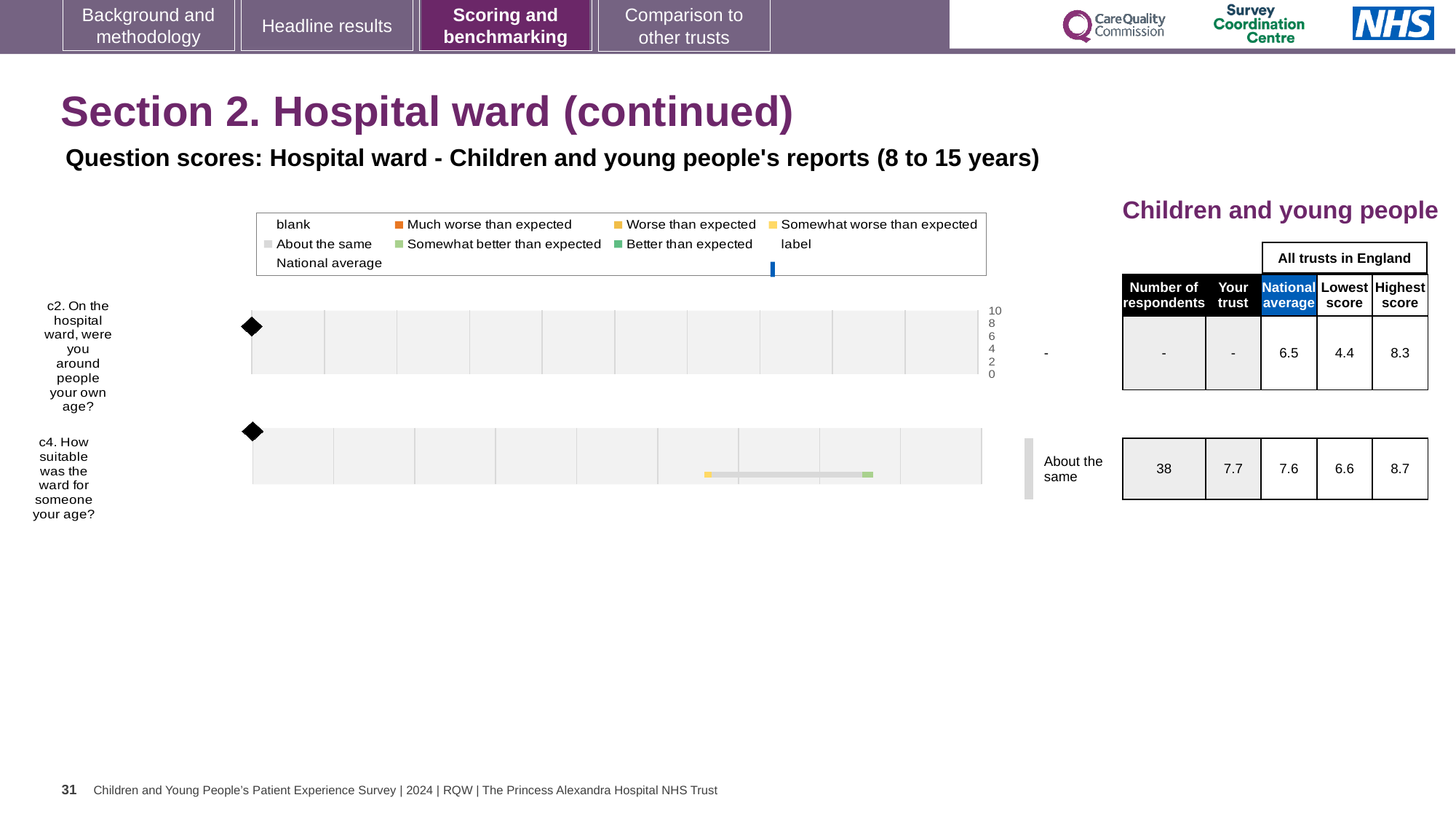
What kind of chart is used to show the question scores on this slide? bar chart How many respondents answered question c4? 38 What is the 'Your trust' score for question c4 (How suitable was the ward for someone your age?)? 7.7 What is the lowest score among all trusts in England for question c2? 4.4 What is the national average score for question c4? 7.6 For question c4, which is higher: the 'Your trust' score or the national average? Your trust What is the highest score among all trusts in England for question c2? 8.3 How many questions (c2, c4) are plotted in the chart area? 2 For question c4, what is the difference between the highest score (8.7) and the lowest score (6.6) across all trusts in England? 2.1 In the chart legend, what does the blue marker represent? National average What is the national average score for question c2? 6.5 What is the maximum value shown on the chart's score axis? 10